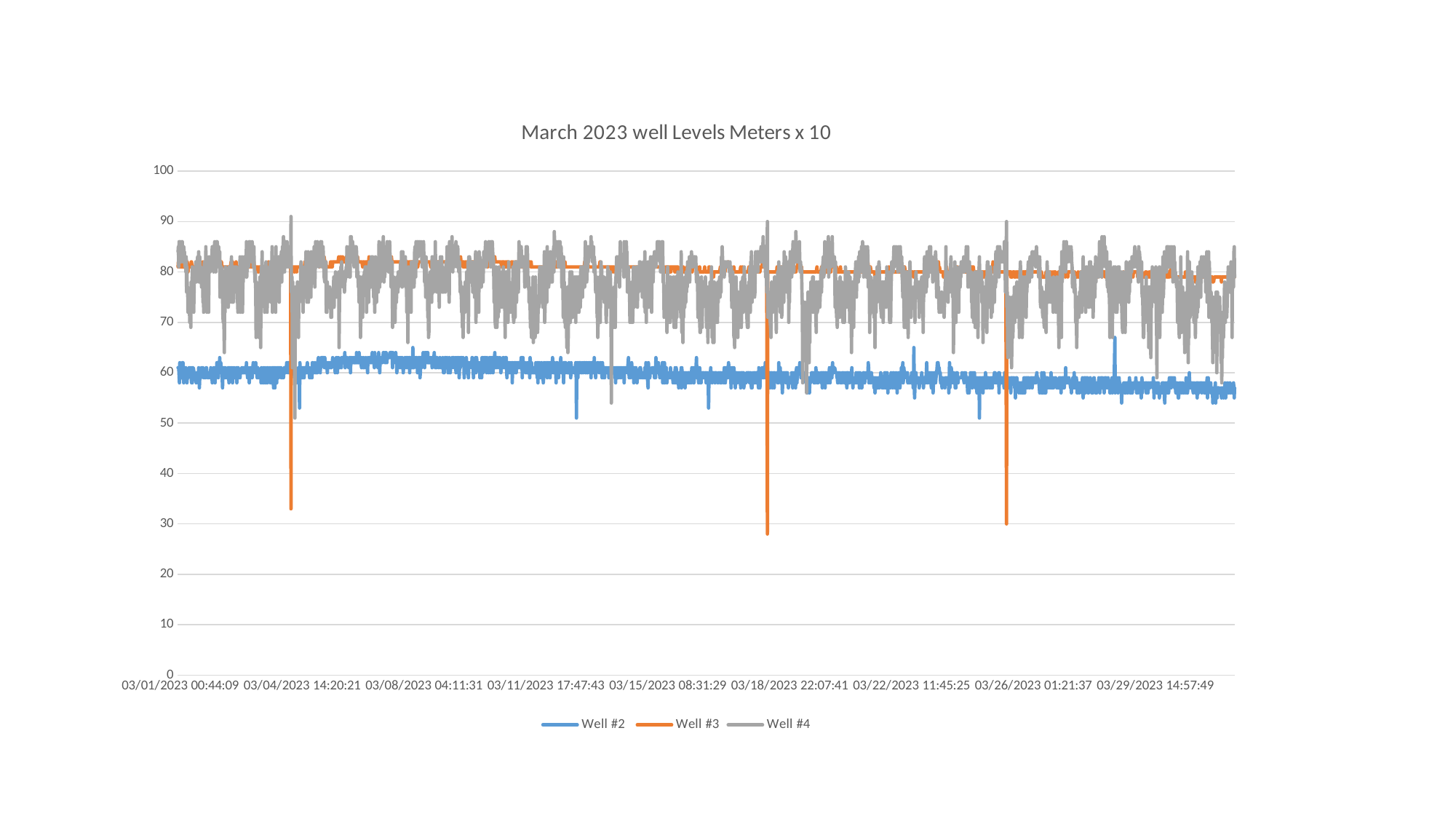
Is the value for Well #2 at the start of the month (03/01/2023) greater or less than 70? less Which series shows the deepest downward spikes, dropping below 40? Well #3 What is the title of the chart? March 2023 well Levels Meters x 10 How many series does the legend list? 3 Is the lowest value reached by Well #3 greater or less than 40? less Is the value for Well #3 at the start of the month (03/01/2023) greater or less than 70? greater How many date labels are shown along the x axis? 9 Which series has the lowest values for most of the month? Well #2 What kind of chart is shown on the slide? line chart At the start of the month, which is larger: the value for Well #2 or the value for Well #4? Well #4 Which colour is used for the Well #3 series? orange